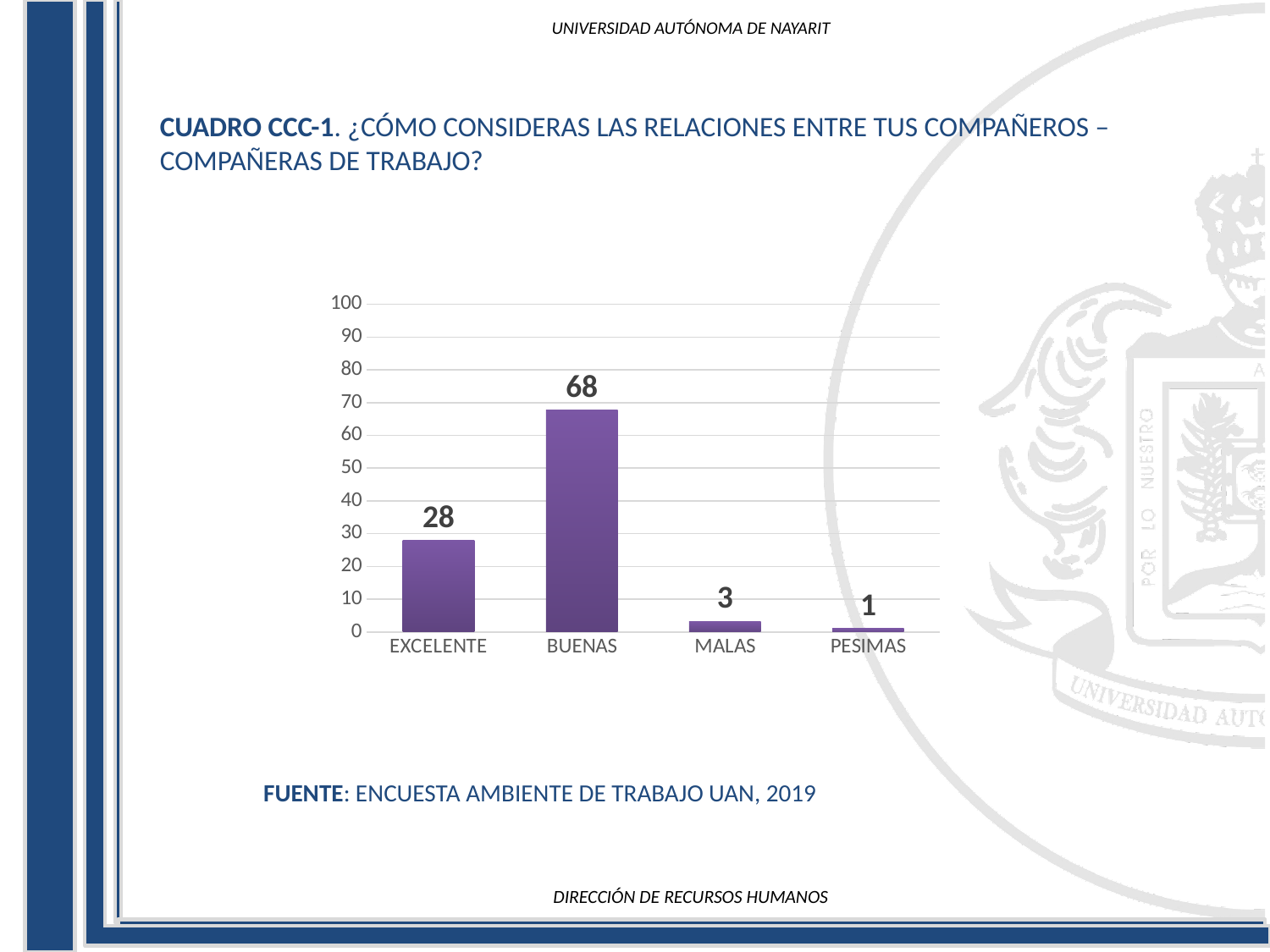
What is the value for BUENAS? 68 Which category has the lowest value? PESIMAS What is the value for EXCELENTE? 28 What is the source cited below the chart? ENCUESTA AMBIENTE DE TRABAJO UAN, 2019 How many categories are shown on the x axis? 4 What kind of chart is shown on the slide? bar chart Is the value for BUENAS greater or less than 60? greater Which is larger, the value for EXCELENTE or the value for MALAS? EXCELENTE Which category has the highest value? BUENAS What is the difference between the values for BUENAS and EXCELENTE? 40 What is the value for MALAS? 3 What is the value for PESIMAS? 1